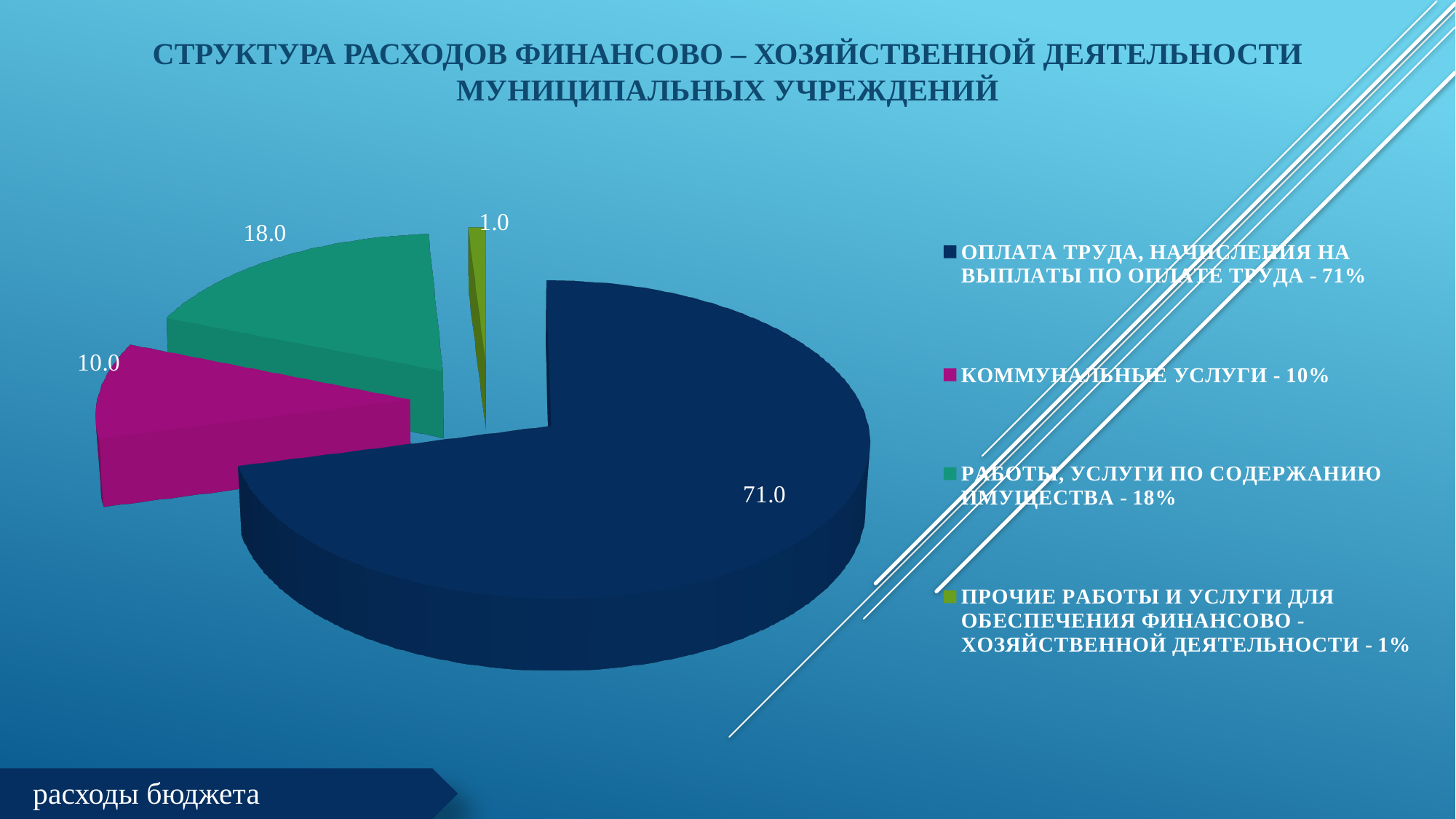
What is the data label on the slice for КОММУНАЛЬНЫЕ УСЛУГИ? 10.0 What is the data label on the slice for РАБОТЫ, УСЛУГИ ПО СОДЕРЖАНИЮ ИМУЩЕСТВА? 18.0 What kind of chart is shown on the slide? Pie chart Which is larger, the slice for КОММУНАЛЬНЫЕ УСЛУГИ or the slice for РАБОТЫ, УСЛУГИ ПО СОДЕРЖАНИЮ ИМУЩЕСТВА? РАБОТЫ, УСЛУГИ ПО СОДЕРЖАНИЮ ИМУЩЕСТВА What is the data label on the slice for ОПЛАТА ТРУДА, НАЧИСЛЕНИЯ НА ВЫПЛАТЫ ПО ОПЛАТЕ ТРУДА? 71.0 What share of the pie does КОММУНАЛЬНЫЕ УСЛУГИ represent according to the legend? 10% What colour is the slice for КОММУНАЛЬНЫЕ УСЛУГИ? Magenta (pink) What is the data label on the slice for ПРОЧИЕ РАБОТЫ И УСЛУГИ ДЛЯ ОБЕСПЕЧЕНИЯ ФИНАНСОВО - ХОЗЯЙСТВЕННОЙ ДЕЯТЕЛЬНОСТИ? 1.0 How many slices does the pie chart have? 4 Which category has the smallest slice of the pie? ПРОЧИЕ РАБОТЫ И УСЛУГИ ДЛЯ ОБЕСПЕЧЕНИЯ ФИНАНСОВО - ХОЗЯЙСТВЕННОЙ ДЕЯТЕЛЬНОСТИ What is the difference between the values for РАБОТЫ, УСЛУГИ ПО СОДЕРЖАНИЮ ИМУЩЕСТВА and КОММУНАЛЬНЫЕ УСЛУГИ? 8.0 Which category has the largest slice of the pie? ОПЛАТА ТРУДА, НАЧИСЛЕНИЯ НА ВЫПЛАТЫ ПО ОПЛАТЕ ТРУДА